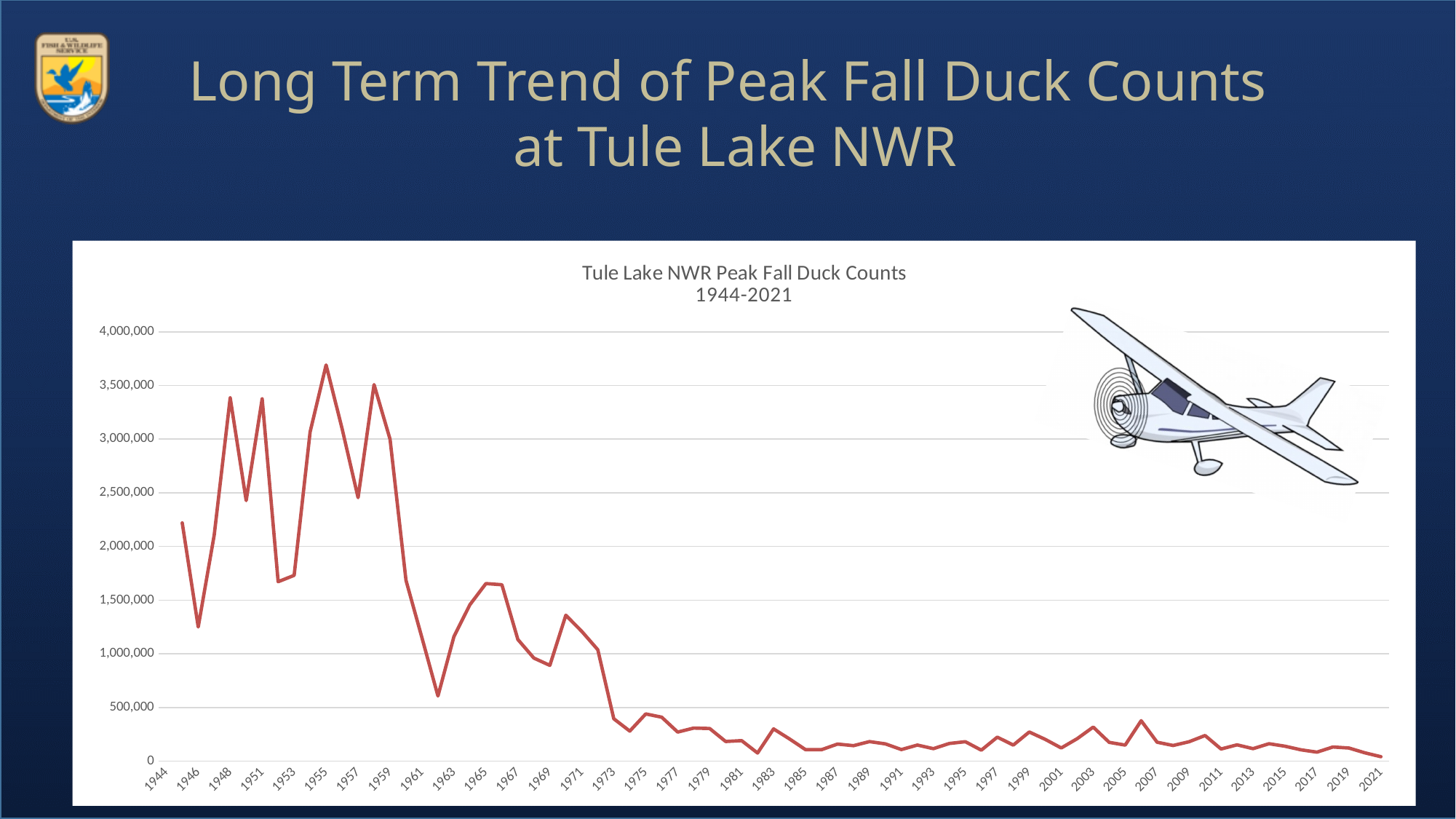
Is the value for 1995 greater or less than 500,000? less What is the highest value shown on the vertical axis? 4,000,000 Is the highest value on the chart greater or less than 3,500,000? greater Overall, do the peak fall duck counts rise or fall from 1944 to 2021? fall What is the title of the chart? Tule Lake NWR Peak Fall Duck Counts 1944-2021 Is the value for 2021 greater or less than 500,000? less What kind of chart is shown on the slide? line chart How many data series are plotted on the chart? 1